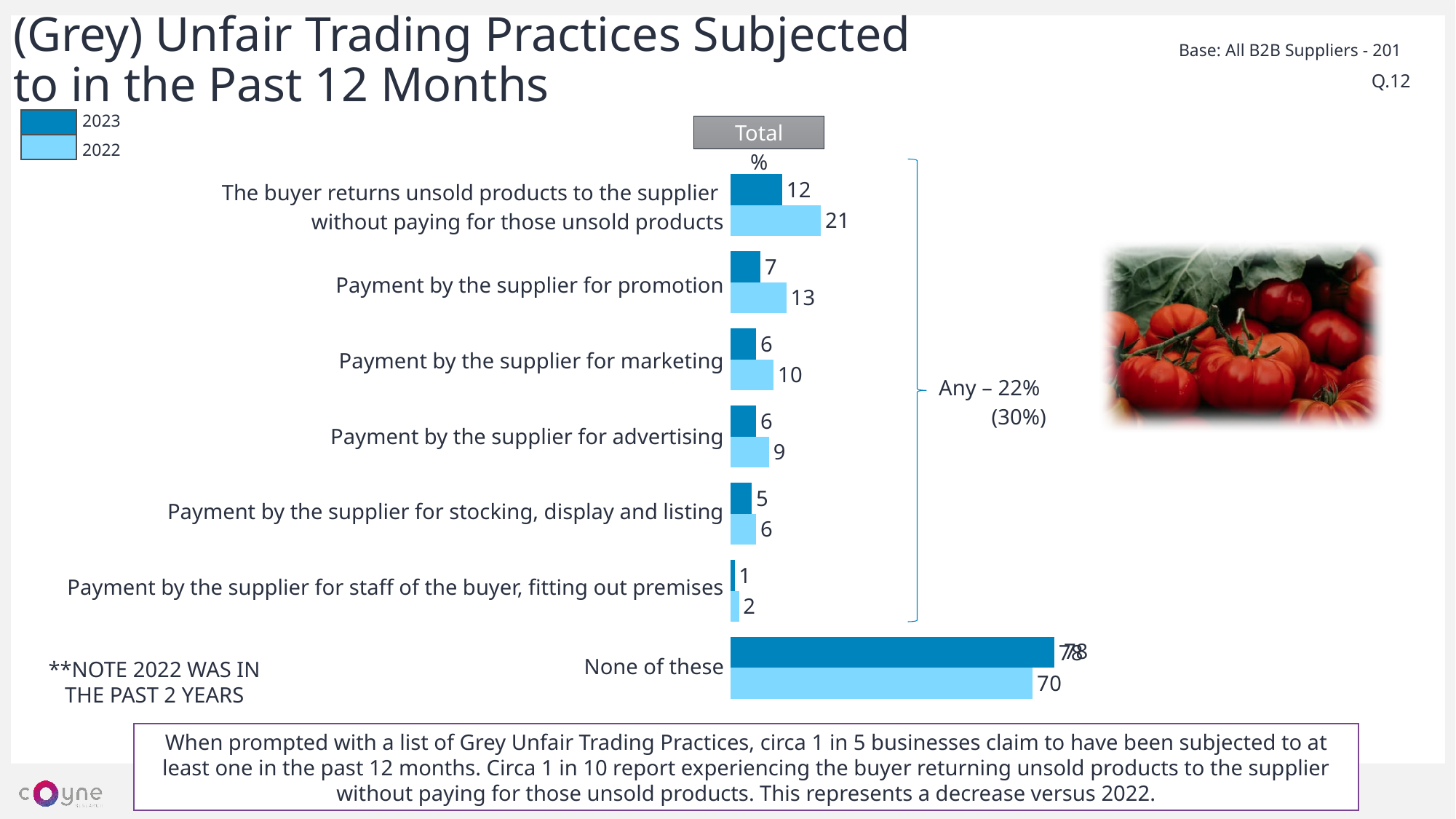
Which category has the lowest 2023 value? Payment by the supplier for staff of the buyer, fitting out premises Which is larger for 'Payment by the supplier for marketing': the 2023 value or the 2022 value? 2022 What is the 2023 value for 'Payment by the supplier for staff of the buyer, fitting out premises'? 1 Excluding 'None of these', which practice has the highest 2022 value? The buyer returns unsold products to the supplier without paying for those unsold products How many series does the legend list? 2 What is the 2023 value for 'The buyer returns unsold products to the supplier without paying for those unsold products'? 12 What is the 2022 value for 'Payment by the supplier for promotion'? 13 What is the 2022 value for 'None of these'? 70 What kind of chart is shown on the slide? Bar chart What percentage is given for 'Any' in 2023 next to the bracket? 22% How many categories are shown in the chart? 7 What is the difference between the 2022 and 2023 values for 'The buyer returns unsold products to the supplier without paying for those unsold products'? 9